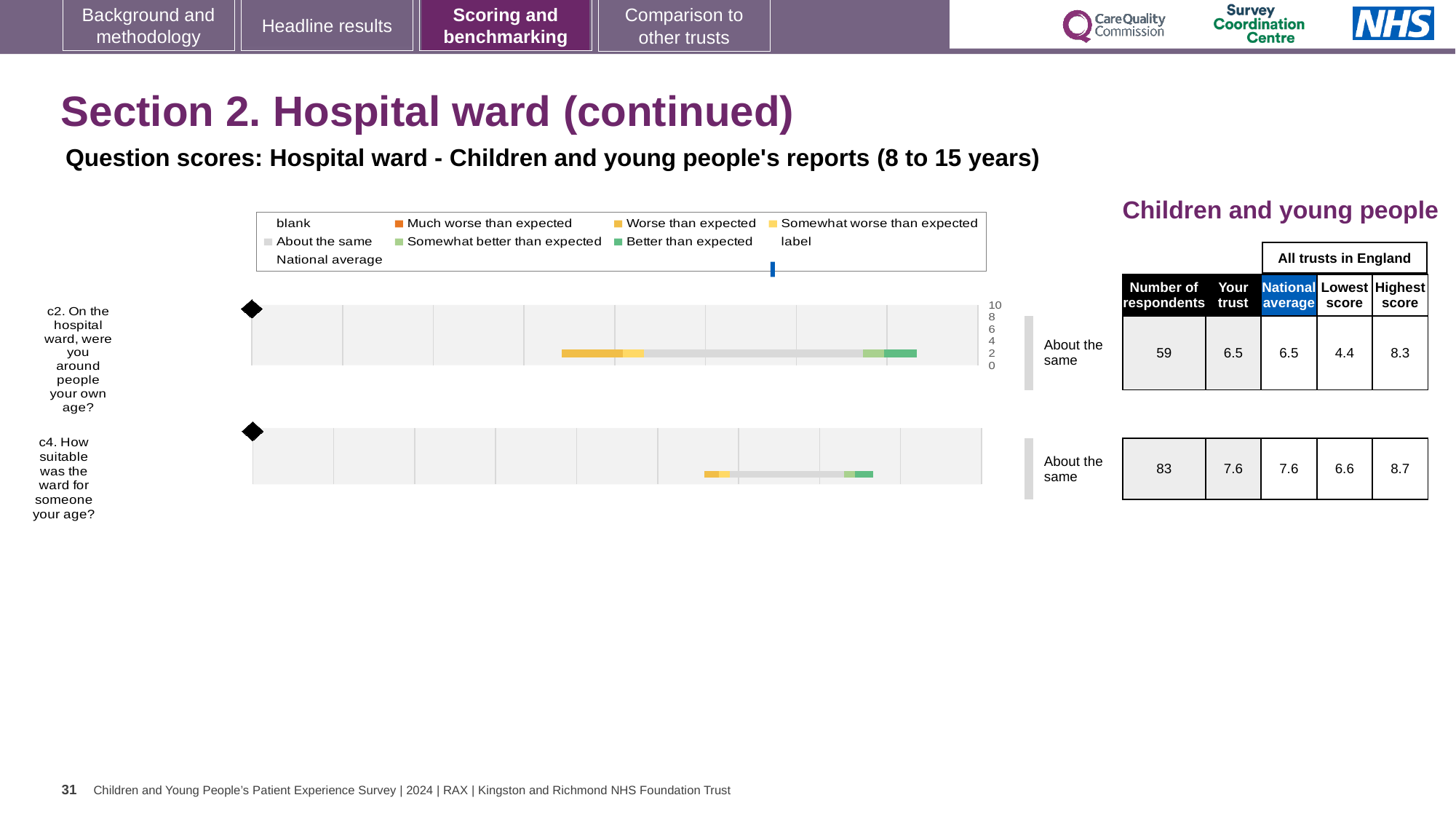
What is the difference between the highest and lowest scores across all trusts for c2? 3.9 What is the highest score across all trusts in England for c4? 8.7 What is the national average score for c4? 7.6 What kind of chart is used to show the question scores for c2 and c4? bar chart How many questions are plotted on the chart? 2 Which question has the higher 'Your trust' score, c2 or c4? c4 What is the difference between the highest and lowest scores across all trusts for c4? 2.1 What is the lowest score across all trusts in England for c2? 4.4 What is the 'Your trust' score for c4 (How suitable was the ward for someone your age?)? 7.6 What is the 'Your trust' score for c2 (On the hospital ward, were you around people your own age?)? 6.5 How many respondents answered question c2? 59 What benchmark category is shown next to the bar for c2? About the same